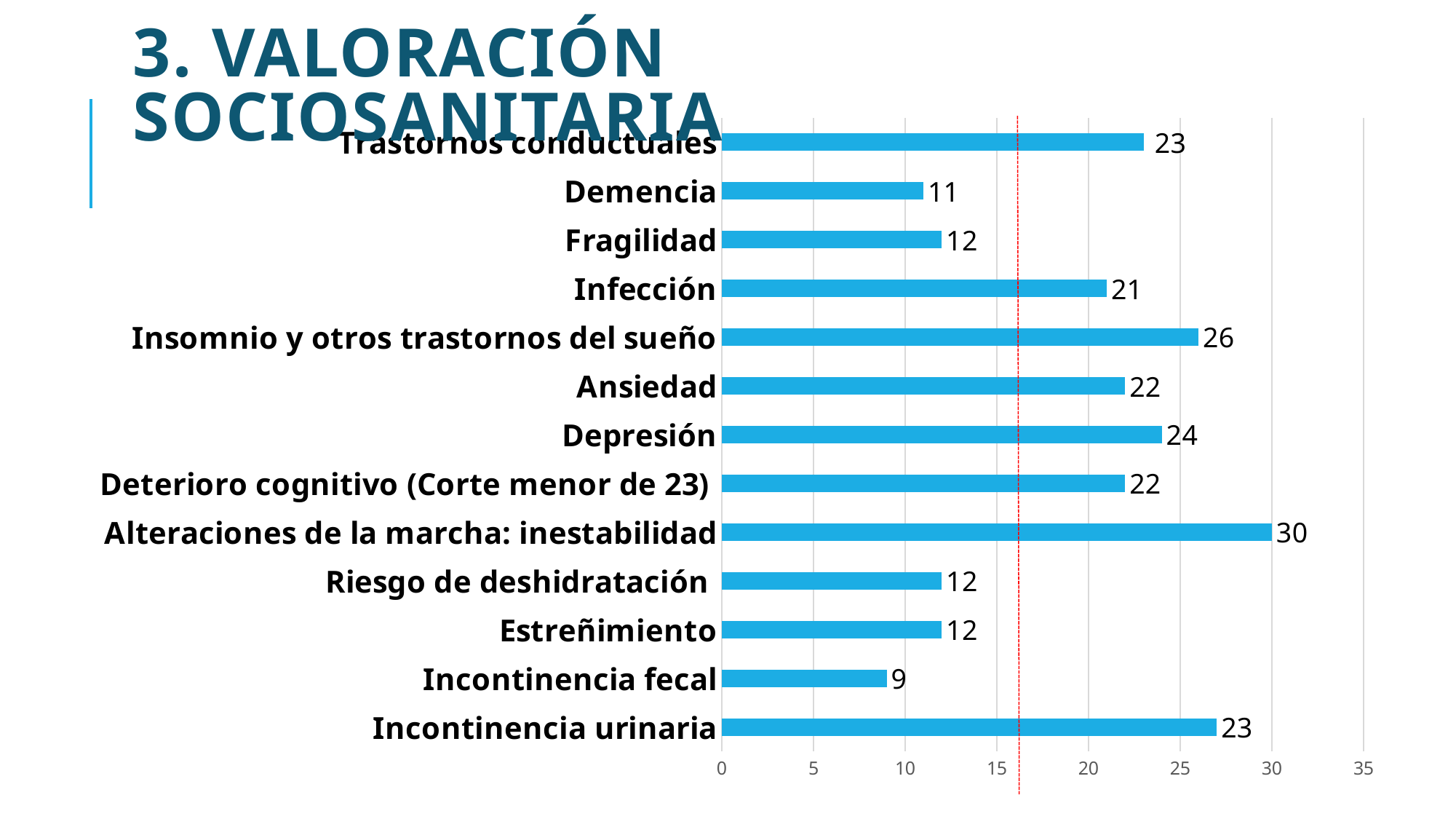
What is the value for Insomnio y otros trastornos del sueño? 26 Which category has the lowest value? Incontinencia fecal How many categories are plotted in the chart? 13 Which is larger, the value for Infección or the value for Fragilidad? Infección What is the value for Incontinencia fecal? 9 What is the value for Alteraciones de la marcha: inestabilidad? 30 What is the value for Depresión? 24 Is the value for Ansiedad greater or less than 20? greater What colour are the bars in the chart? blue Which category has the highest value? Alteraciones de la marcha: inestabilidad What type of chart is shown on the slide? bar chart What is the difference between the values for Alteraciones de la marcha: inestabilidad and Demencia? 19